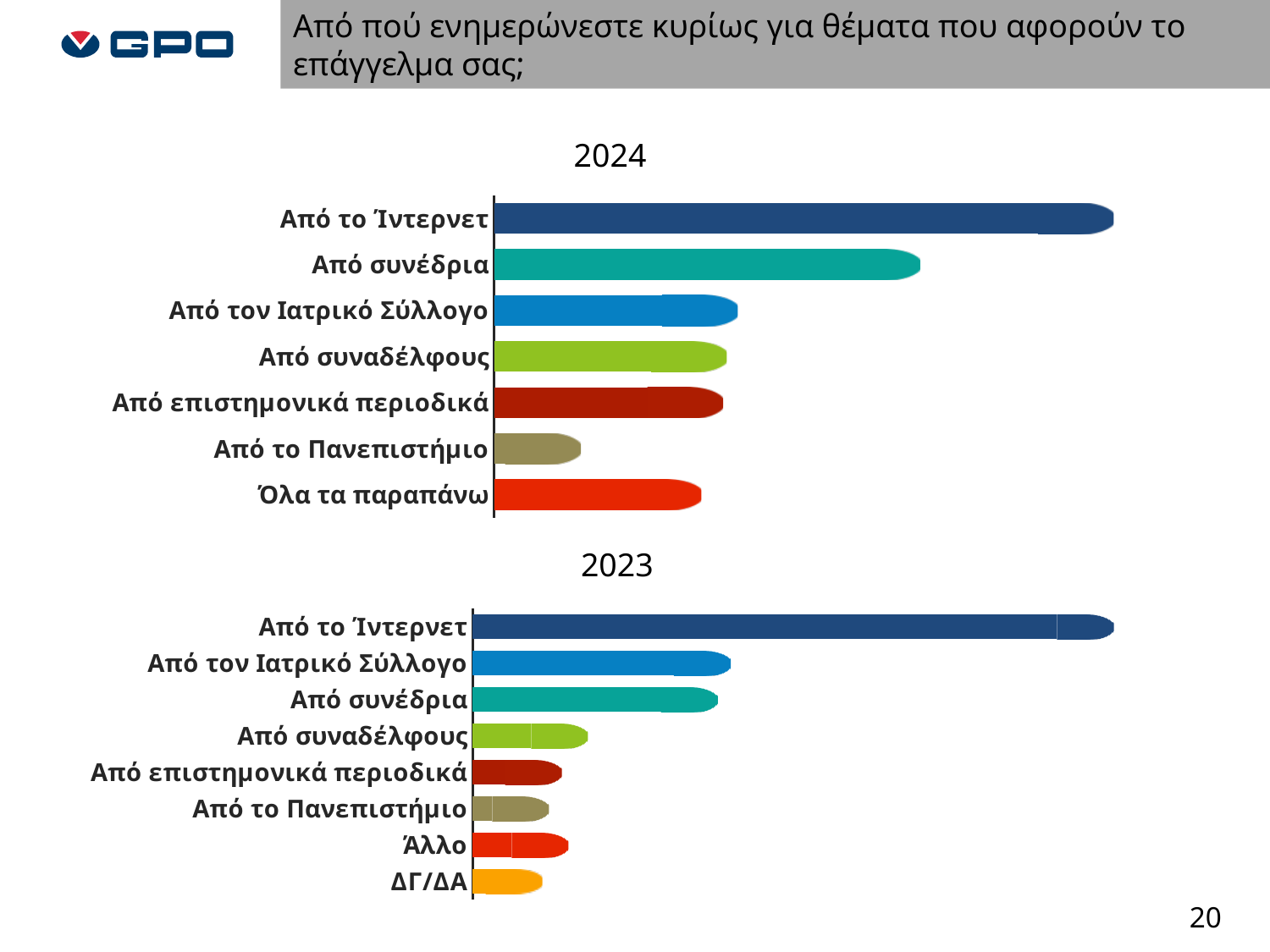
In the 2023 chart, which is larger: Από συνέδρια or Από συναδέλφους? Από συνέδρια How many categories are shown in the 2023 chart? 8 In the 2023 chart, which category has the lowest value? ΔΓ/ΔΑ What kind of chart is the 2024 chart? Bar chart How many charts are on the slide? 2 What is the title of the top chart on the slide? 2024 In the 2024 chart, which is larger: Όλα τα παραπάνω or Από το Πανεπιστήμιο? Όλα τα παραπάνω In the 2023 chart, which category has the highest value? Από το Ίντερνετ How many categories are shown in the 2024 chart? 7 In the 2024 chart, which category has the lowest value? Από το Πανεπιστήμιο In the 2024 chart, which is larger: Από συνέδρια or Από τον Ιατρικό Σύλλογο? Από συνέδρια In the 2024 chart, which category has the highest value? Από το Ίντερνετ